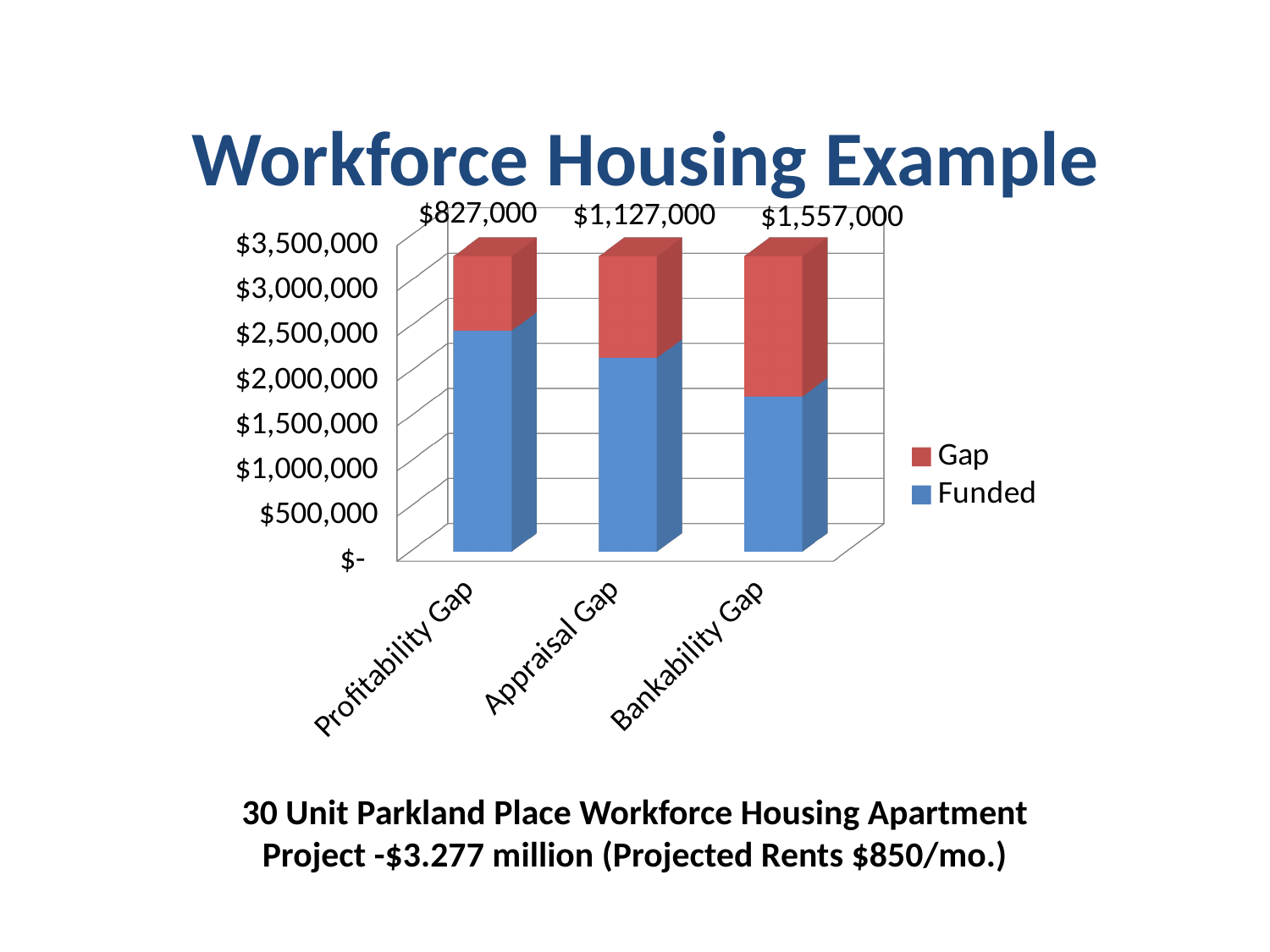
Which category has the largest Gap value? Bankability Gap What is the difference between the Gap values for Appraisal Gap and Profitability Gap? $300,000 Which category has the smallest Gap value? Profitability Gap How many categories are shown on the x axis? 3 What kind of chart is shown on the slide? Stacked bar chart What is the Gap value shown for Appraisal Gap? $1,127,000 Is the Funded value for Bankability Gap greater or less than $2,000,000? less How many series does the legend list? 2 What is the difference between the Gap values for Bankability Gap and Profitability Gap? $730,000 Which has a larger Gap value, Appraisal Gap or Bankability Gap? Bankability Gap What is the Gap value shown for Profitability Gap? $827,000 What is the Gap value shown for Bankability Gap? $1,557,000